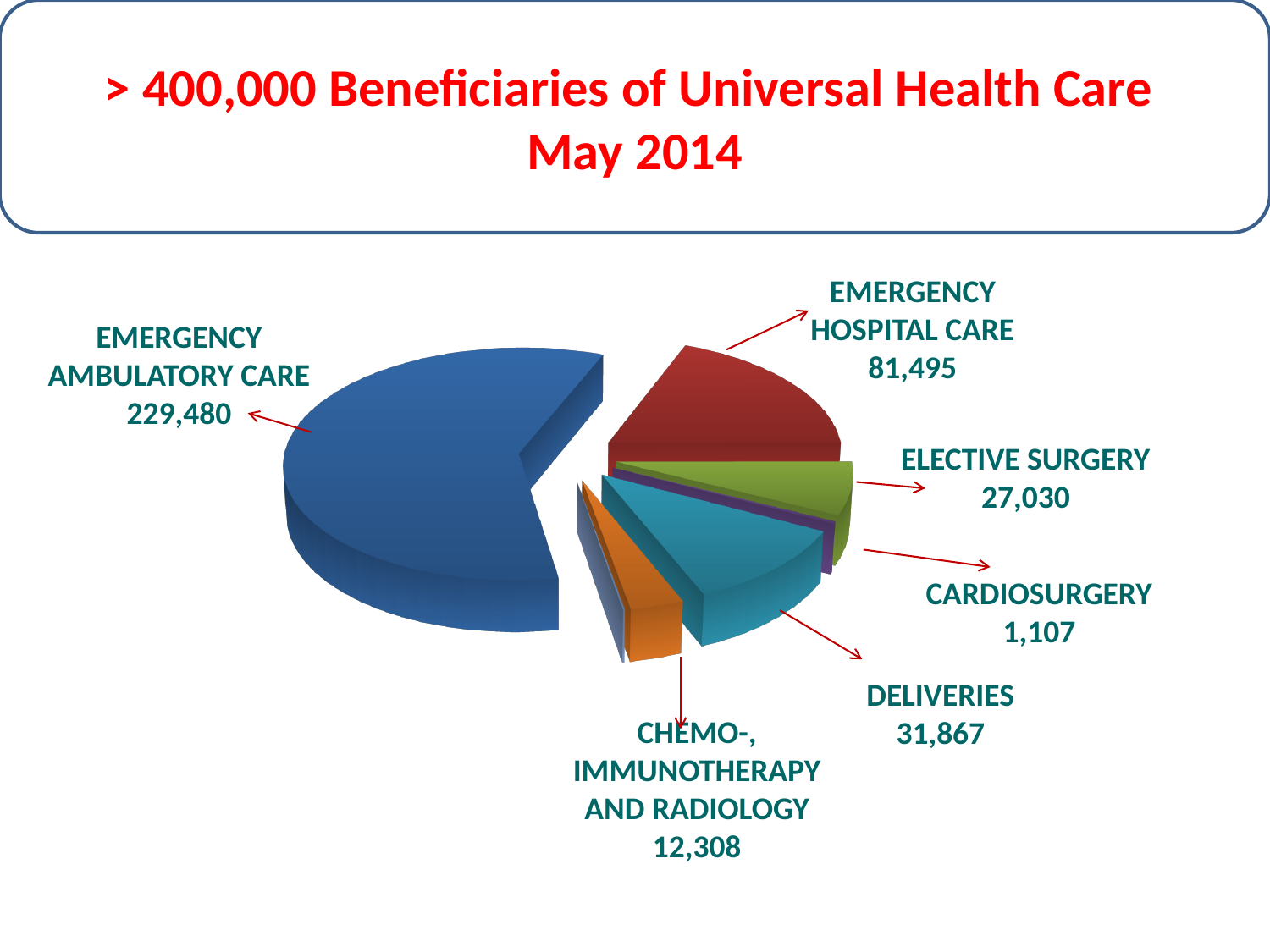
How many categories (slices) does the pie chart show? 6 What is the difference between Deliveries and Elective Surgery? 4,837 What is the title of the slide containing the chart? > 400,000 Beneficiaries of Universal Health Care May 2014 What is the value for Deliveries? 31,867 What is the value for Emergency Hospital Care? 81,495 Which category has the smallest value? Cardiosurgery What kind of chart is shown on the slide? Pie chart What is the value for Chemo-, Immunotherapy and Radiology? 12,308 Which category has the largest slice of the pie? Emergency Ambulatory Care Which is larger, Elective Surgery or Deliveries? Deliveries What is the difference between Emergency Ambulatory Care and Emergency Hospital Care? 147,985 What is the value for Emergency Ambulatory Care? 229,480